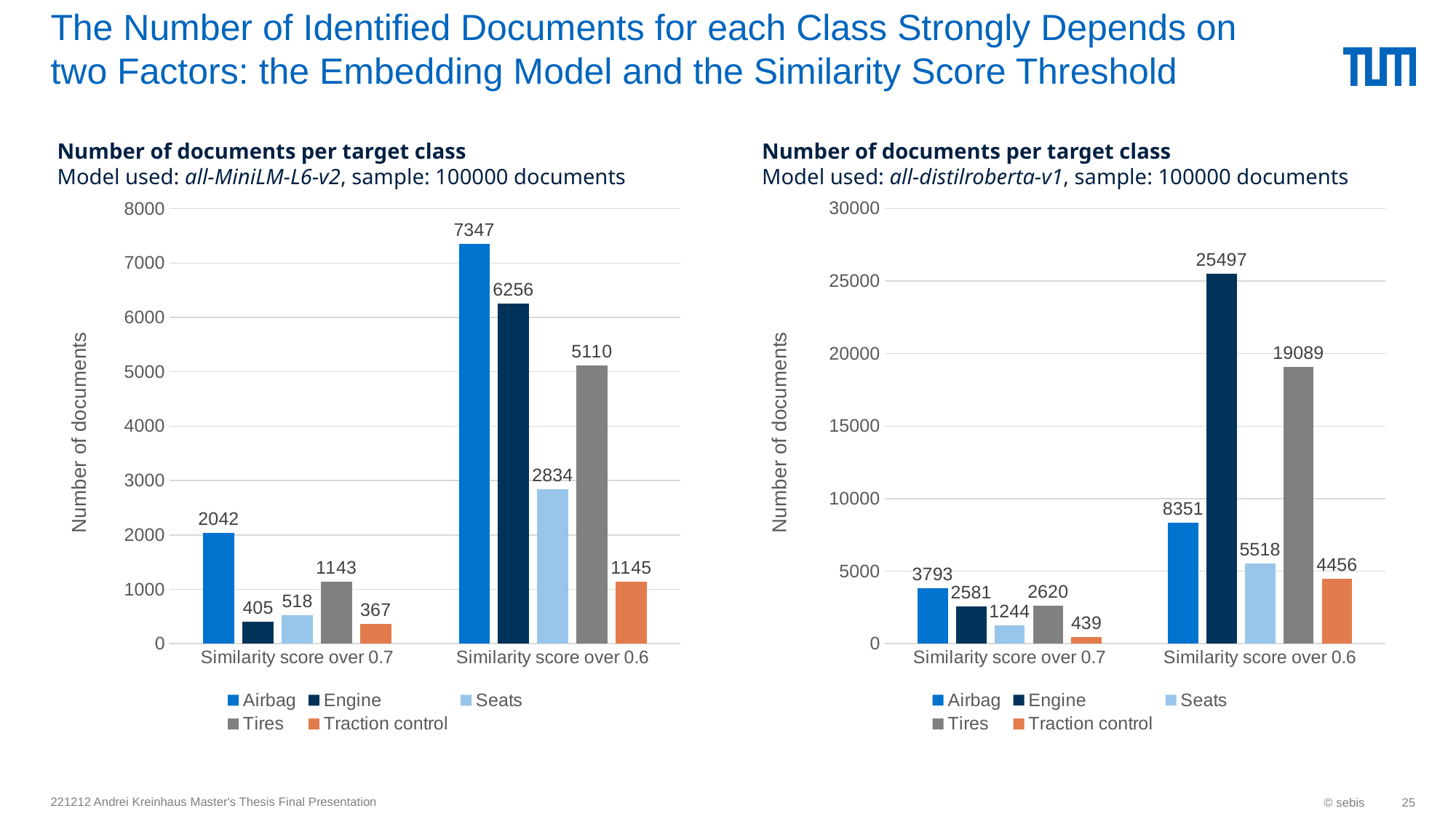
What kind of chart is the right chart (all-distilroberta-v1)? Bar chart In the left chart (all-MiniLM-L6-v2), what is the number of documents for Airbag at similarity score over 0.6? 7347 In the right chart (all-distilroberta-v1), which is larger at similarity score over 0.7: Engine or Tires? Tires In the right chart (all-distilroberta-v1), what is the number of documents for Engine at similarity score over 0.6? 25497 How many similarity score categories are shown on the x axis of the left chart (all-MiniLM-L6-v2)? 2 In the right chart (all-distilroberta-v1), which class has the highest number of documents at similarity score over 0.6? Engine In the left chart (all-MiniLM-L6-v2), is the value for Seats at similarity score over 0.6 greater or less than 3000? less In the right chart (all-distilroberta-v1), what is the difference between Engine and Tires at similarity score over 0.6? 6408 In the left chart (all-MiniLM-L6-v2), what is the difference between the Airbag values at similarity score over 0.6 and over 0.7? 5305 In the left chart (all-MiniLM-L6-v2), which class has the lowest number of documents at similarity score over 0.7? Traction control In the left chart (all-MiniLM-L6-v2), what is the label of the y axis? Number of documents How many series does the legend of the right chart (all-distilroberta-v1) list? 5